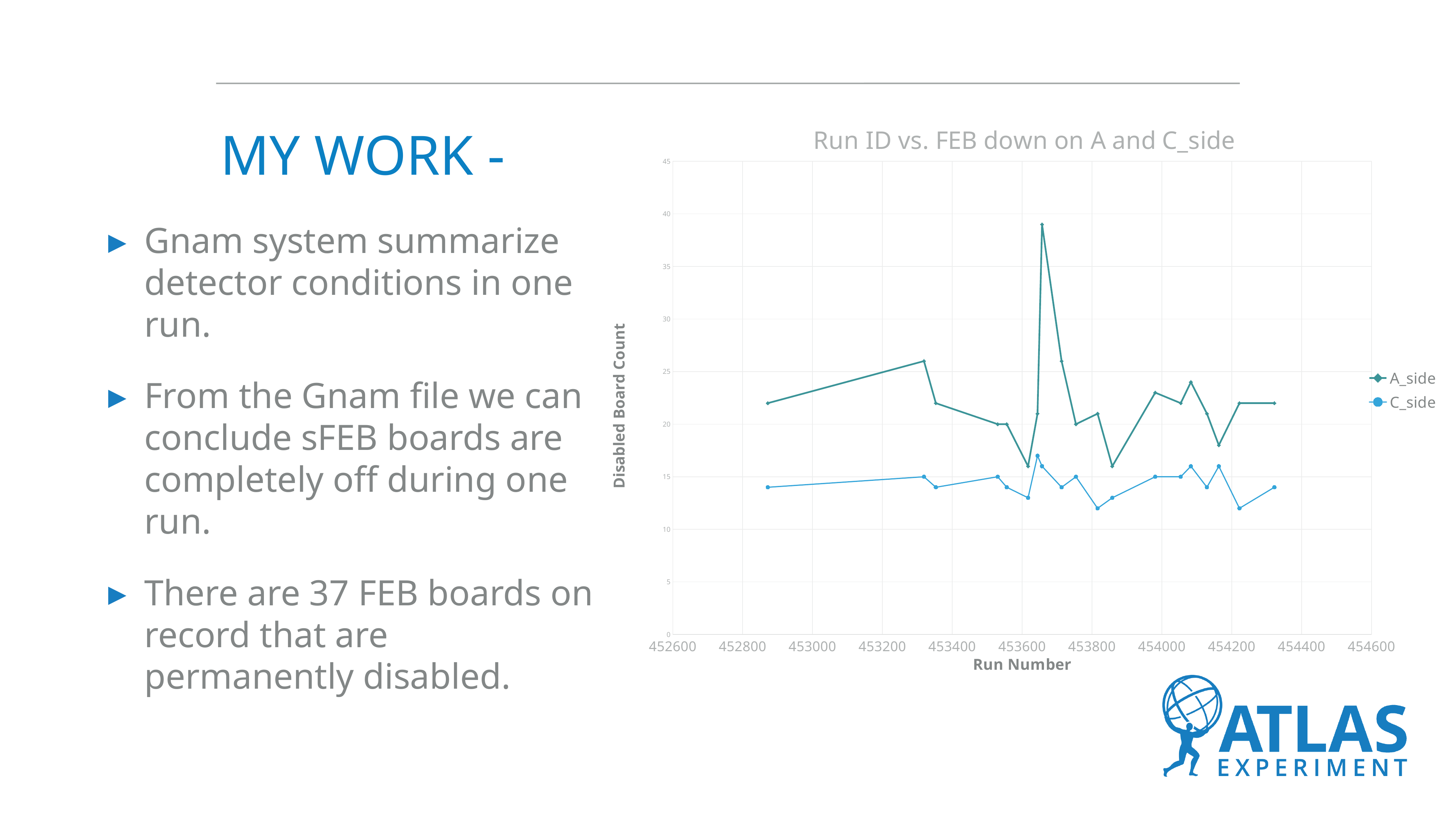
What is the title of the chart? Run ID vs. FEB down on A and C_side What are the two series named in the chart's legend? A_side and C_side How many series does the chart's legend list? 2 Which series reaches the highest Disabled Board Count on the chart? A_side Is the lowest value of the C_side series greater or less than 10? greater Is the peak value of the A_side series greater or less than 35? greater Which series has the lowest values on the chart? C_side Around run number 453650, which series has the larger Disabled Board Count, A_side or C_side? A_side Is the first plotted value of the A_side series (near run 452900) greater or less than 20? greater Which series is plotted in the darker teal colour with diamond markers? A_side What kind of chart is shown on the slide? line chart